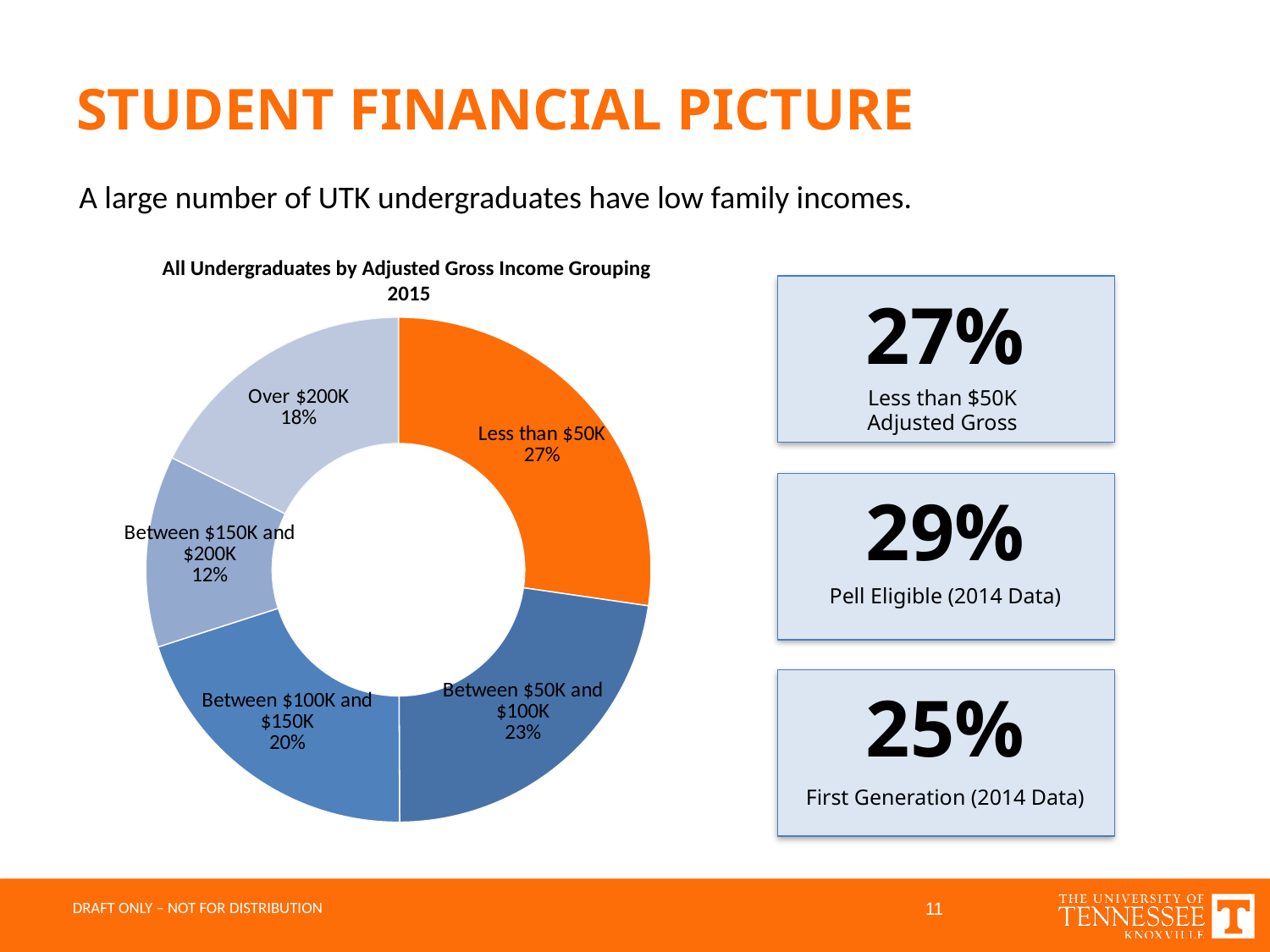
What kind of chart is used to show undergraduates by adjusted gross income grouping? Doughnut chart What is the difference in percentage points between the Less than $50K and Over $200K groupings? 9 What share of undergraduates have an adjusted gross income of less than $50K? 27% What share of undergraduates have an adjusted gross income over $200K? 18% Which income grouping is shown in orange on the chart? Less than $50K Which income grouping has the smallest share of undergraduates? Between $150K and $200K What is the title of the chart? All Undergraduates by Adjusted Gross Income Grouping 2015 Which income grouping has the largest share of undergraduates? Less than $50K What share of undergraduates fall in the Between $50K and $100K income grouping? 23% Which grouping has a larger share: Between $100K and $150K or Between $50K and $100K? Between $50K and $100K How many income groupings are shown in the chart? 5 What share of undergraduates fall in the Between $150K and $200K income grouping? 12%